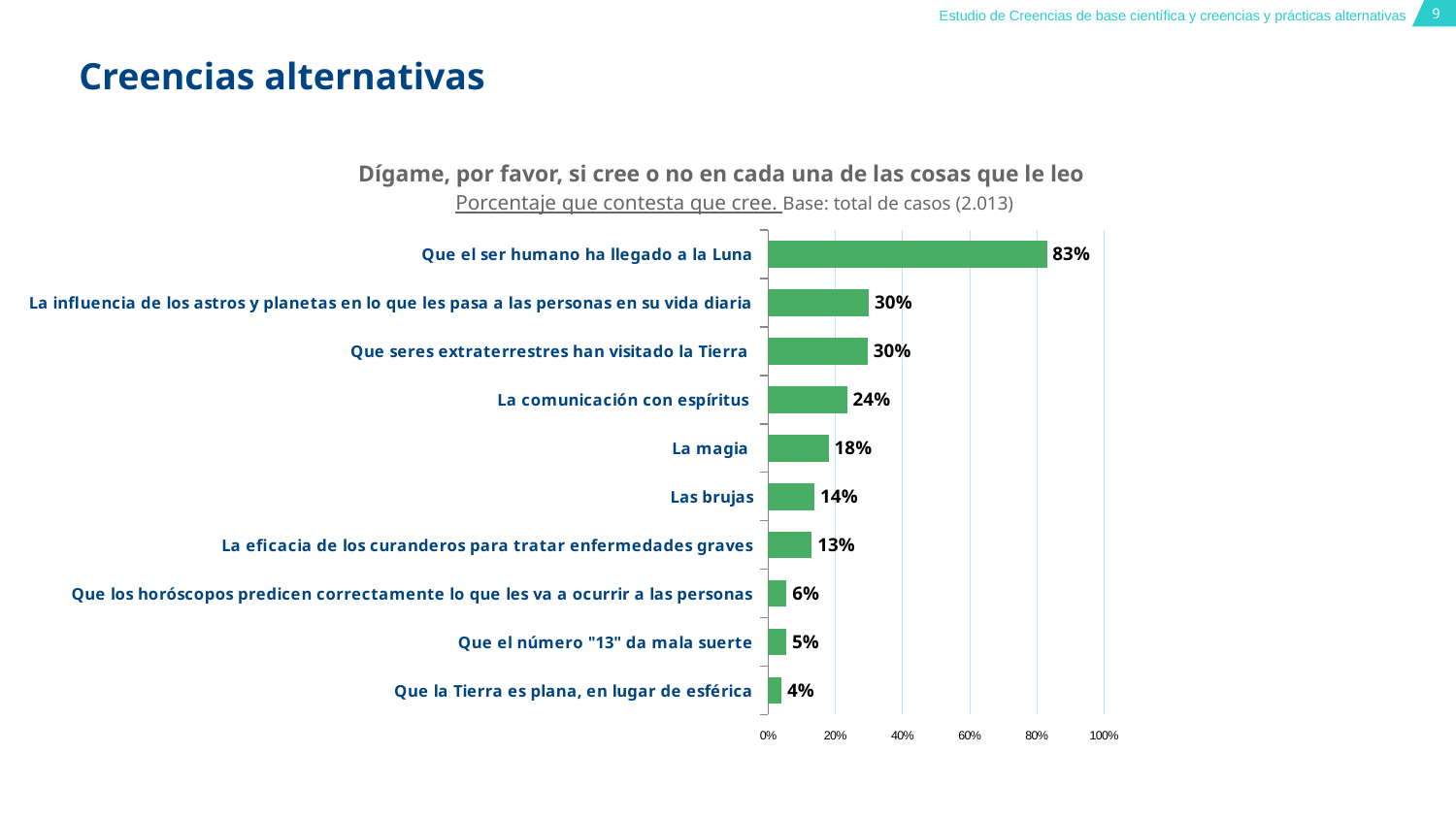
How many categories are shown in the chart? 10 Which is larger: the value for 'La comunicación con espíritus' or the value for 'La eficacia de los curanderos para tratar enfermedades graves'? La comunicación con espíritus What percentage of respondents say they believe that humans have reached the Moon (Que el ser humano ha llegado a la Luna)? 83% What percentage believe in 'Las brujas'? 14% What is the difference between the value for 'La magia' and the value for 'Las brujas'? 4% What is the base (number of cases) stated in the chart subtitle? 2.013 What is the difference between the value for 'Que el ser humano ha llegado a la Luna' and the value for 'Que la Tierra es plana, en lugar de esférica'? 79% What is the value for 'La comunicación con espíritus'? 24% Which category has the lowest percentage? Que la Tierra es plana, en lugar de esférica Which category has the highest percentage? Que el ser humano ha llegado a la Luna Is the value for 'Que seres extraterrestres han visitado la Tierra' greater or less than 20%? greater What kind of chart is shown on the slide? Bar chart